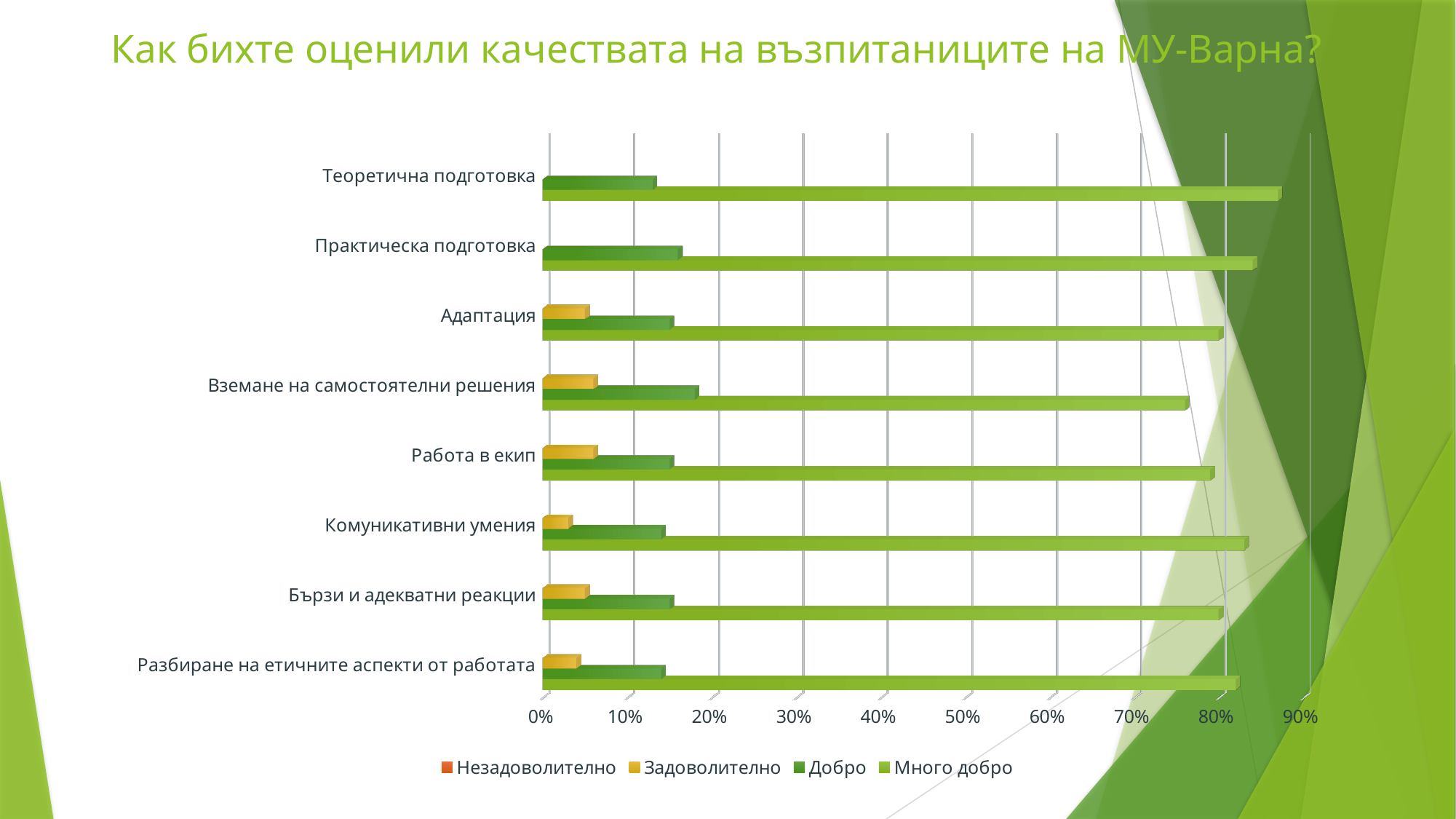
Is the 'Много добро' value for 'Вземане на самостоятелни решения' greater or less than 80%? less For the 'Много добро' series, which is larger: 'Теоретична подготовка' or 'Практическа подготовка'? Теоретична подготовка How many series does the chart legend list? 4 How many categories are listed on the vertical axis of the chart? 8 Is the 'Задоволително' value for 'Комуникативни умения' greater or less than 10%? less Which category has the lowest value for the 'Много добро' series? Вземане на самостоятелни решения Which category has the highest value for the 'Много добро' series? Теоретична подготовка What is the title of the chart on the slide? Как бихте оценили качествата на възпитаниците на МУ-Варна? What kind of chart is shown on the slide? bar chart Is the 'Добро' value for 'Теоретична подготовка' greater or less than 20%? less Which legend entry is shown in yellow? Задоволително